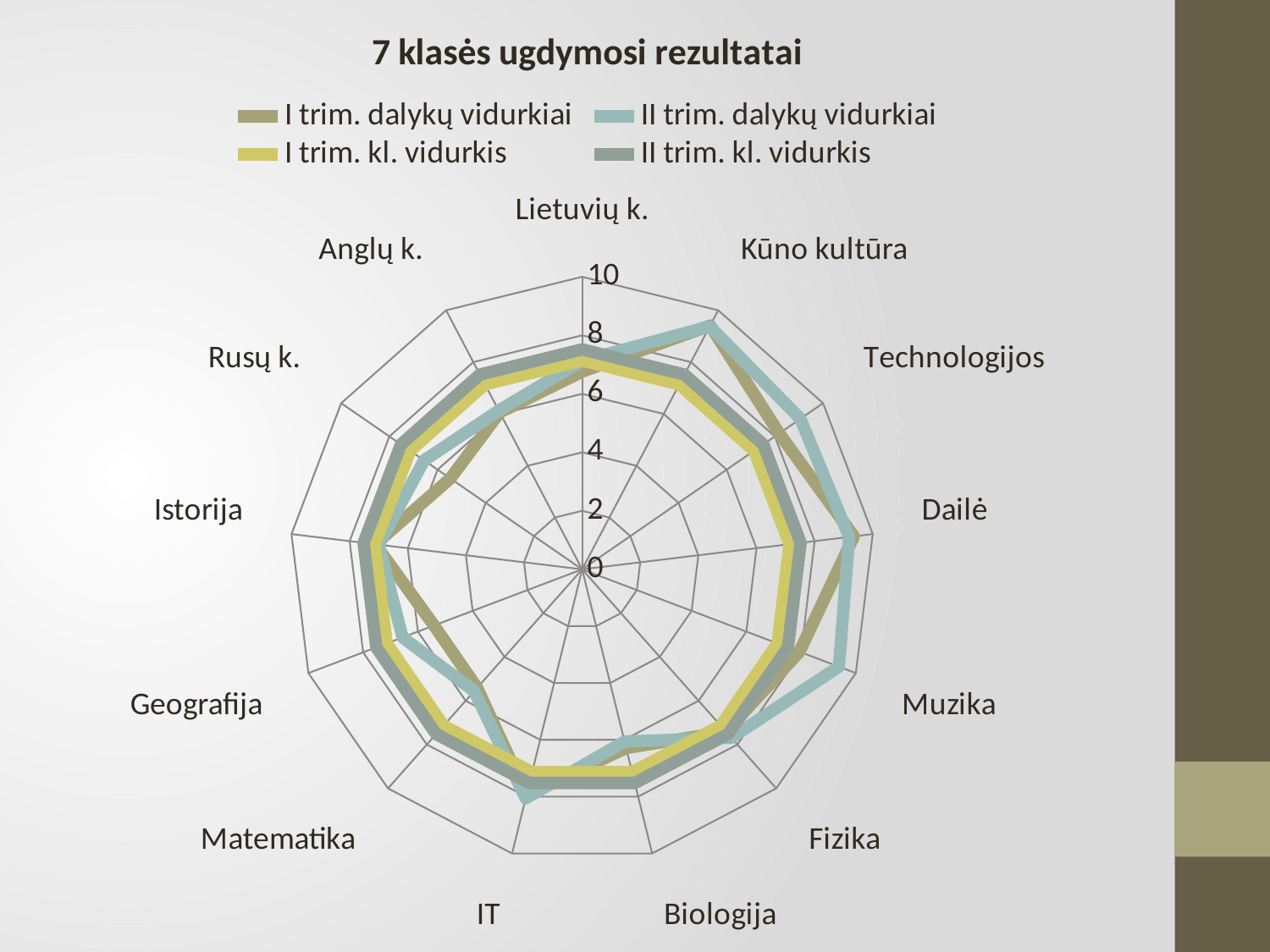
In the II trim. dalykų vidurkiai series, which is larger: the value for Kūno kultūra or the value for Lietuvių k.? Kūno kultūra Which series is shown in yellow in the legend? I trim. kl. vidurkis What is the title of the chart? 7 klasės ugdymosi rezultatai How many subject categories are plotted around the radar chart? 13 Is the value for Istorija in the I trim. dalykų vidurkiai series greater or less than 8? less Is the value for Dailė in the I trim. dalykų vidurkiai series greater or less than 8? greater How many series does the legend list? 4 Is the value for Kūno kultūra in the II trim. dalykų vidurkiai series greater or less than 8? greater In the I trim. dalykų vidurkiai series, which is larger: the value for Dailė or the value for Istorija? Dailė What kind of chart is shown on the slide? Radar chart